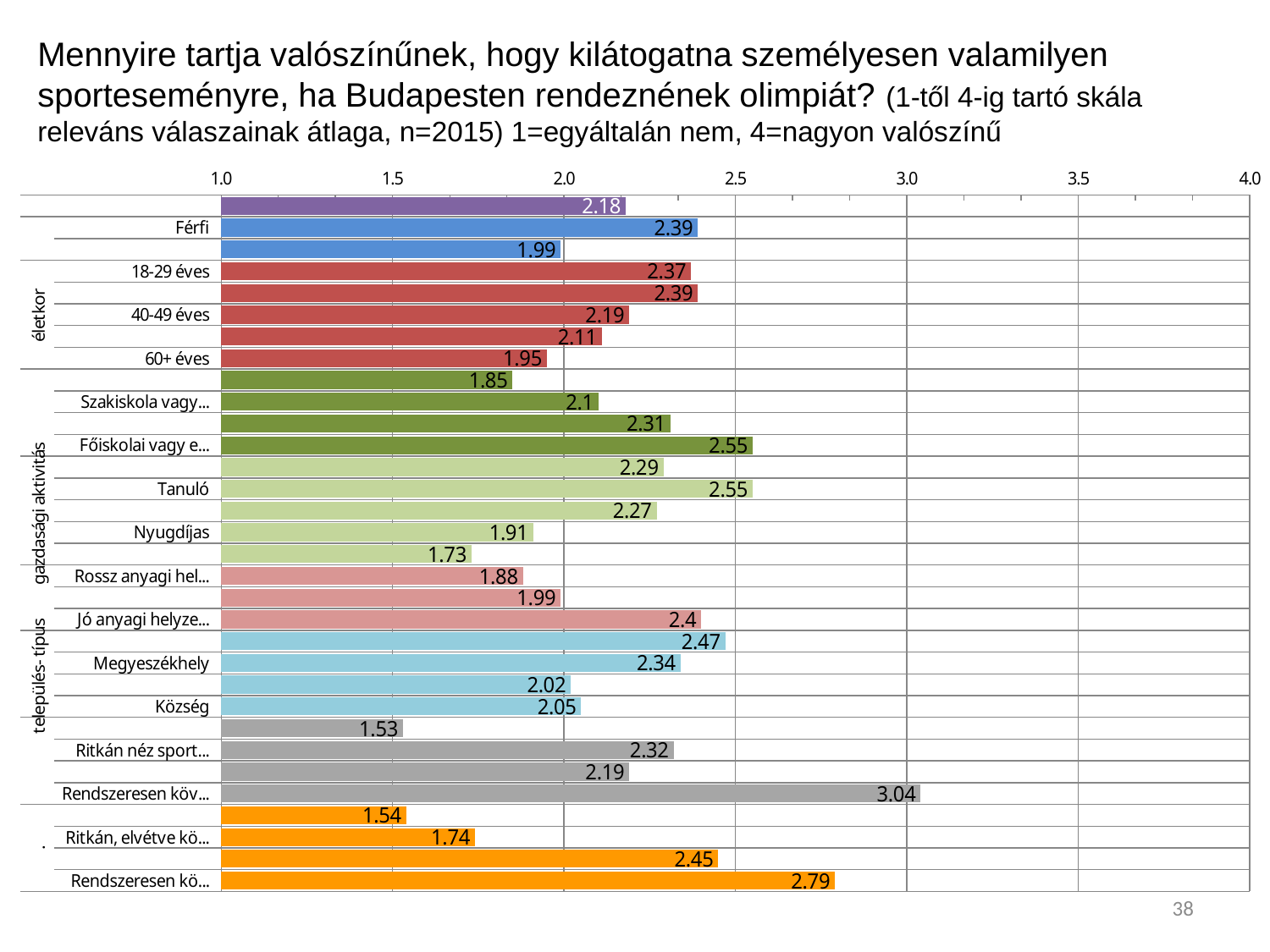
What kind of chart is shown on the slide? Bar chart What is the maximum value shown on the value axis of the chart? 4.0 What is the value for Férfi? 2.39 What is the value for Megyeszékhely? 2.34 What is the value for Község? 2.05 What is the value for Nyugdíjas? 1.91 What is the value for 60+ éves? 1.95 What is the difference between the values for Férfi and 60+ éves? 0.44 What is the highest value shown on the chart? 3.04 What is the value for Tanuló? 2.55 Which has the larger value, Megyeszékhely or Község? Megyeszékhely What is the lowest value shown on the chart? 1.53